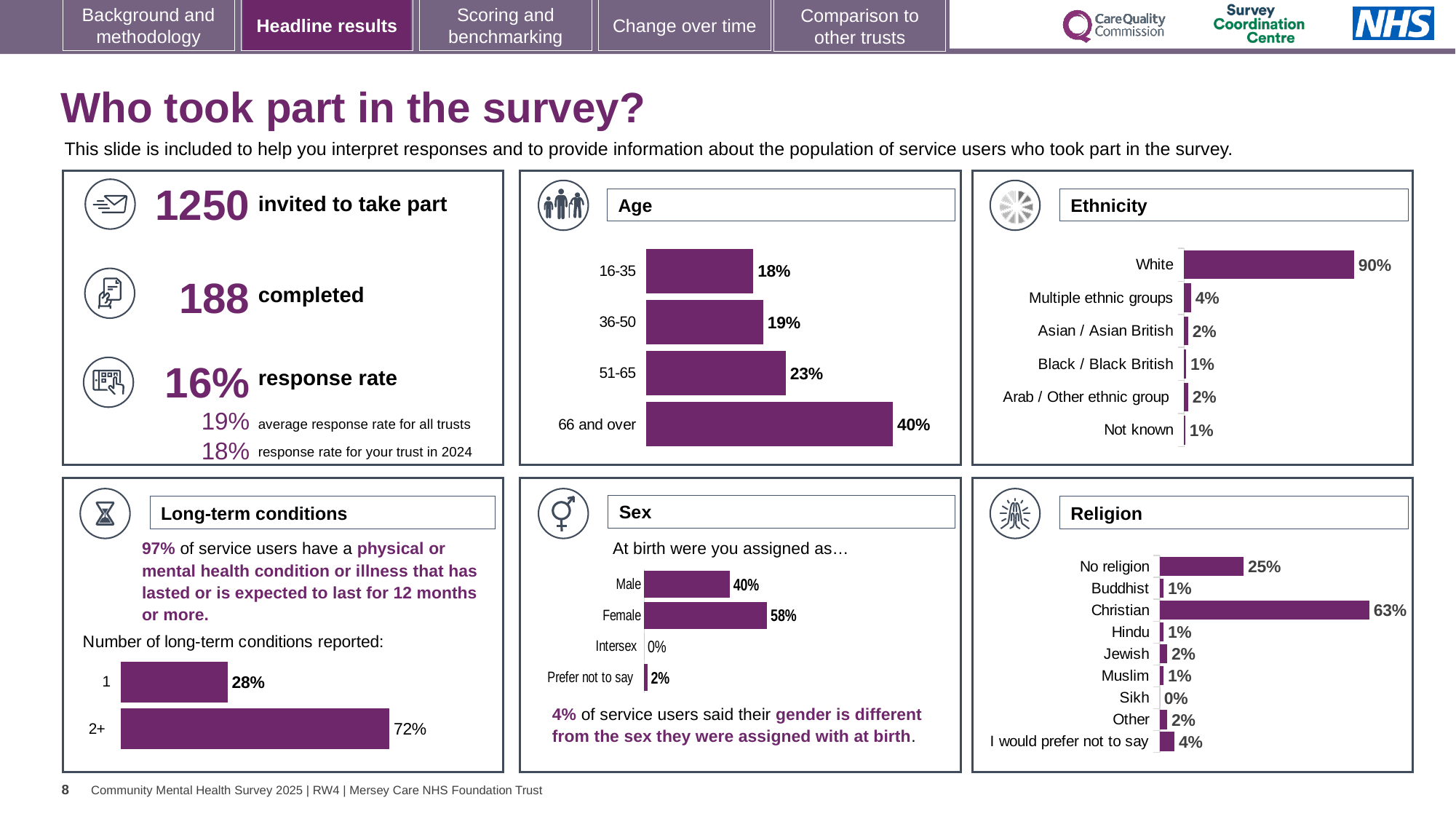
How many categories are shown in the Religion chart? 9 In the Age chart, what percentage of respondents were aged 66 and over? 40% In the Age chart, what is the difference between the 51-65 and 36-50 percentages? 4% In the Religion chart, which category has the highest percentage? Christian In the Long-term conditions chart, what percentage of service users reported 2+ conditions? 72% In the Age chart, which age group has the lowest percentage? 16-35 In the Ethnicity chart, which is larger: Multiple ethnic groups or Asian / Asian British? Multiple ethnic groups What type of chart is used in the Age panel? Bar chart In the Religion chart, what percentage of respondents reported No religion? 25% How many categories are shown in the Ethnicity chart? 6 In the Ethnicity chart, what percentage of respondents were White? 90% In the Sex chart, what percentage of respondents were assigned Female at birth? 58%